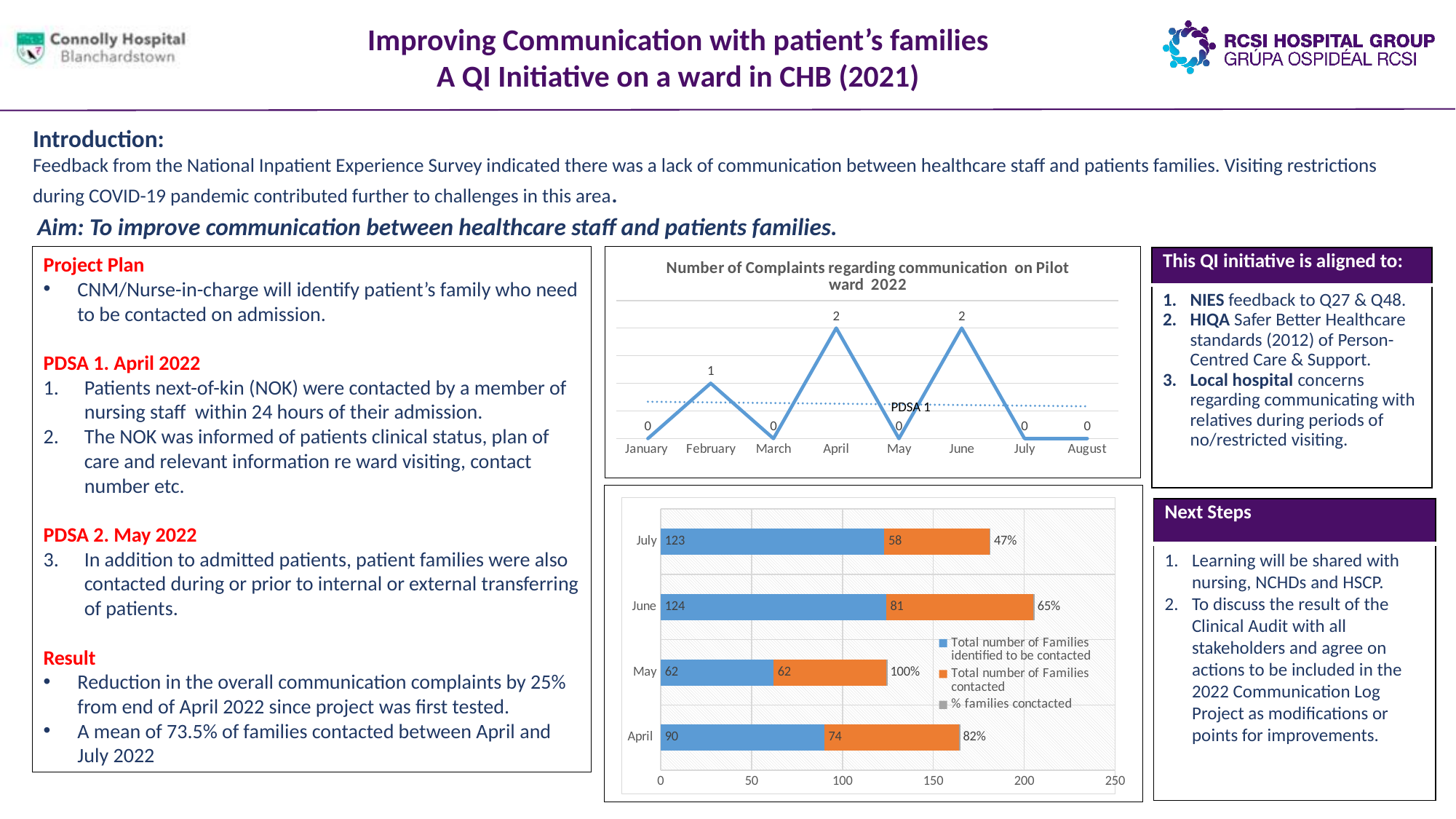
What kind of chart is the 'Number of Complaints regarding communication on Pilot ward 2022' chart? Line chart In the lower stacked bar chart, what is the difference between the number of families identified to be contacted and the number contacted in April? 16 In the lower stacked bar chart, which month has the highest number of families contacted? June In the lower stacked bar chart, what percentage of families was contacted in May? 100% In the 'Number of Complaints regarding communication on Pilot ward 2022' chart, how many months are plotted on the x axis? 8 In the lower stacked bar chart, what is the total number of families identified to be contacted in June? 124 In the 'Number of Complaints regarding communication on Pilot ward 2022' chart, what is the difference between the complaints in June and the complaints in February? 1 In the lower stacked bar chart, how many series does the legend list? 3 In the 'Number of Complaints regarding communication on Pilot ward 2022' chart, how many complaints were recorded in February? 1 In the lower stacked bar chart, what is the total number of families contacted in July? 58 In the 'Number of Complaints regarding communication on Pilot ward 2022' chart, how many complaints were recorded in April? 2 In the lower stacked bar chart, which month has the lowest number of families identified to be contacted? May